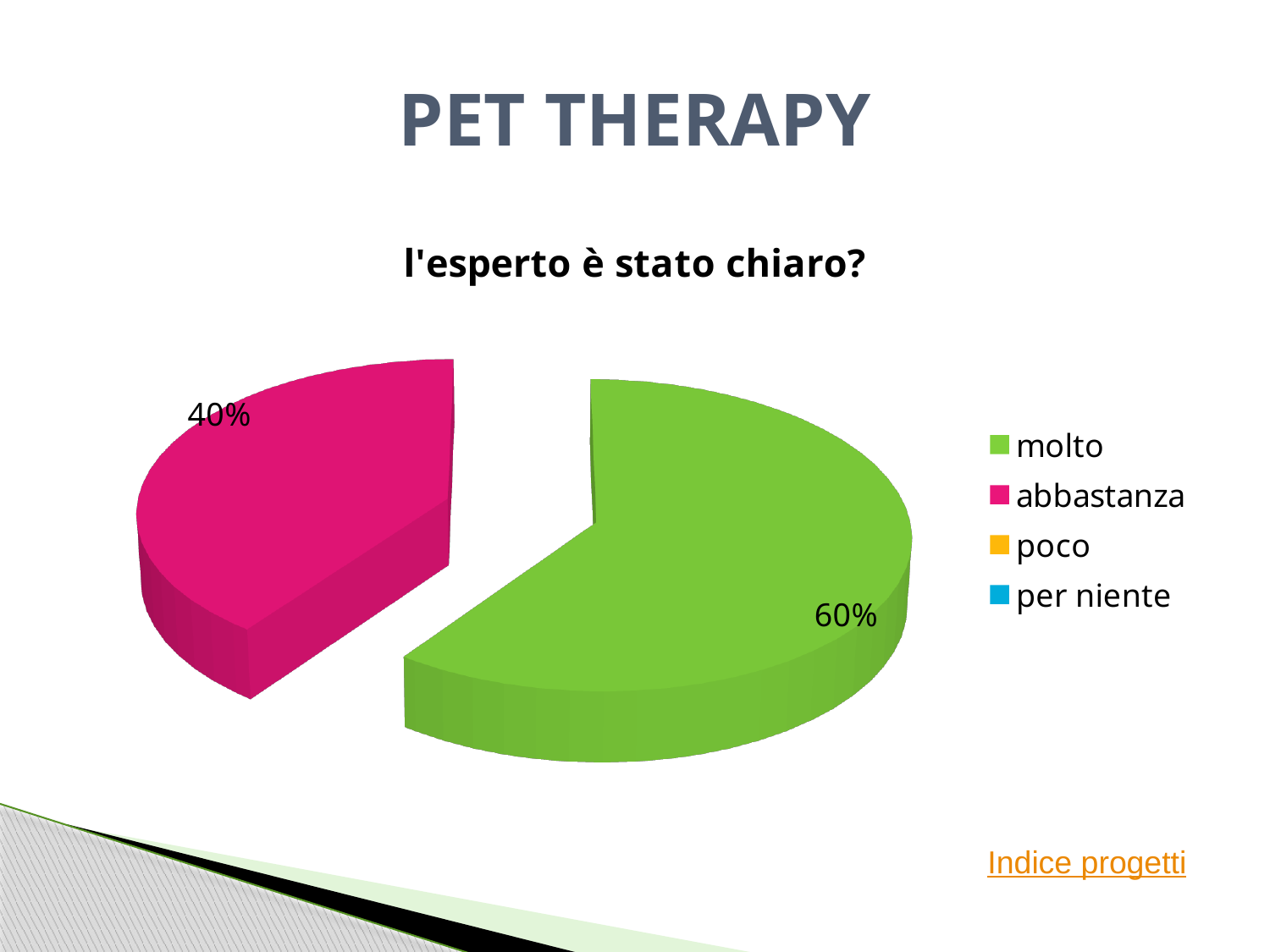
What is the title of the chart? l'esperto è stato chiaro? Which of the two visible slices is larger, "molto" or "abbastanza"? molto What is the difference in percentage points between the "molto" and "abbastanza" slices? 20 percentage points What is the combined share of the "molto" and "abbastanza" slices? 100% What share of the pie does "abbastanza" represent? 40% Is the share for "molto" greater or less than 50%? greater What share of the pie does "molto" represent? 60% How many entries does the legend list? 4 What colour is the "abbastanza" slice? pink What kind of chart is shown on the slide? pie chart Which category has the largest slice of the pie? molto How many slices are visible in the pie? 2